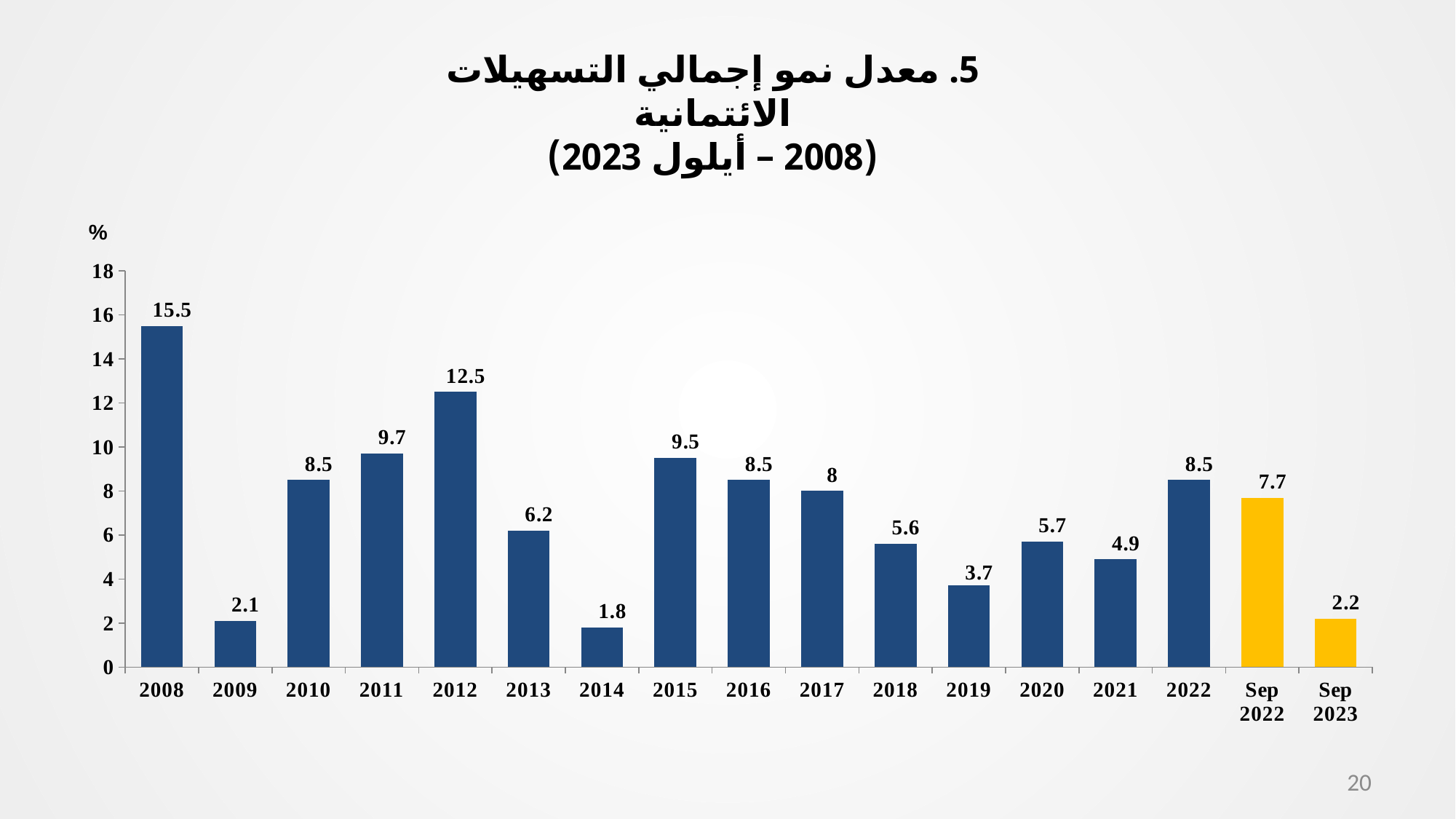
Is the value for 2011 greater or less than 8? greater What kind of chart is shown on the slide? bar chart What is the value for 2014? 1.8 What is the difference between the values for Sep 2022 and Sep 2023? 5.5 What is the value for Sep 2023? 2.2 Which category has the lowest value? 2014 How many bars are shown in the chart? 17 Do the values rise or fall from 2015 to 2019? fall Which two bars are coloured yellow instead of blue? Sep 2022 and Sep 2023 Which year has the highest value? 2008 What is the value for 2008? 15.5 Which is larger, the value for 2012 or the value for 2015? 2012